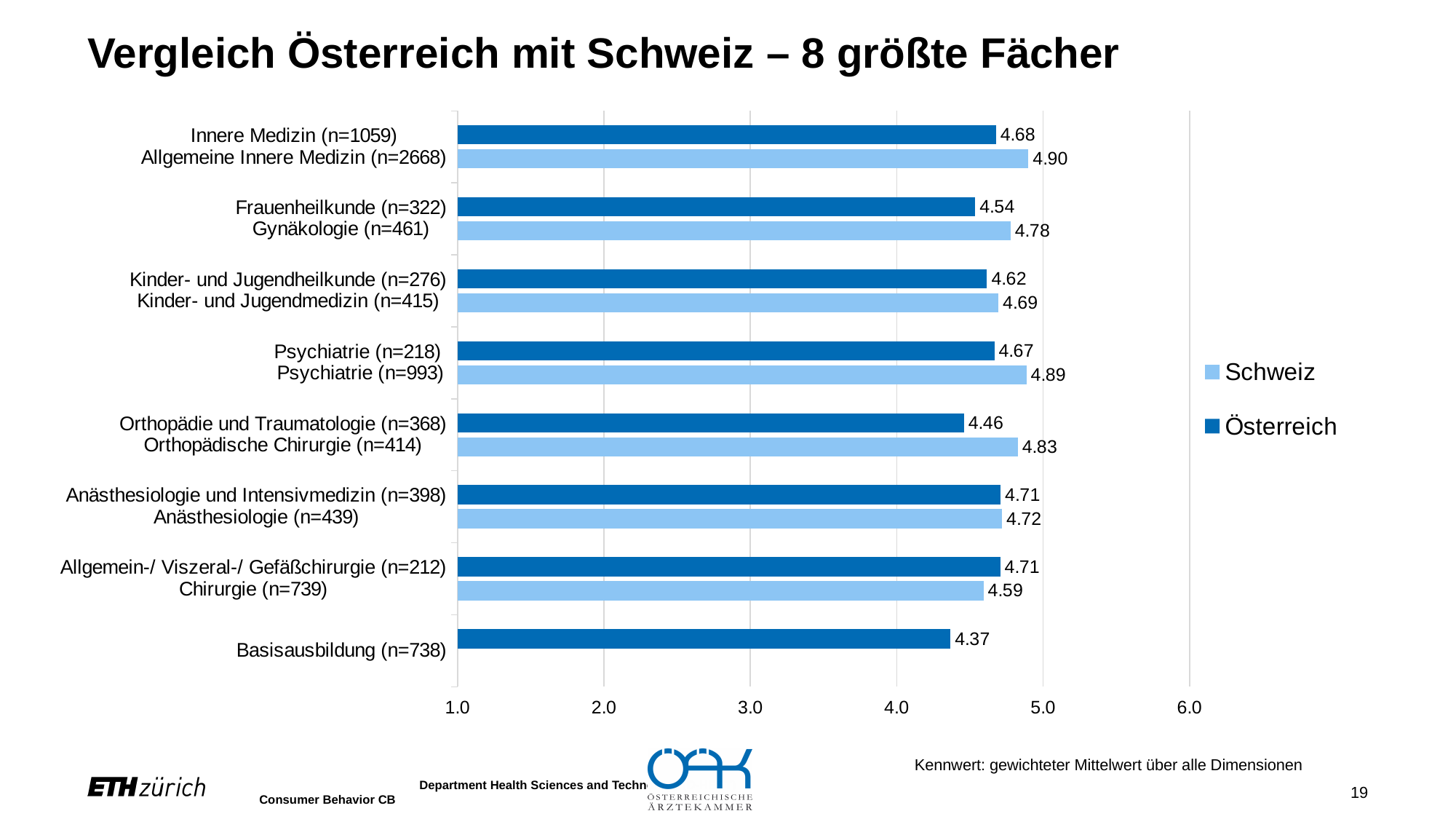
What is the value for Basisausbildung (n=738)? 4.37 Is the value for Psychiatrie (n=993) for Schweiz greater or less than 4.0? greater What is the value for Orthopädische Chirurgie (n=414) for Schweiz? 4.83 Which Österreich category has the lowest value? Basisausbildung (n=738) How many series does the legend list? 2 Which Schweiz category has the highest value? Allgemeine Innere Medizin (n=2668) What kind of chart is shown on the slide? Bar chart What is the difference between the Schweiz value for Gynäkologie (n=461) and the Österreich value for Frauenheilkunde (n=322)? 0.24 Which is larger: the Österreich value for Allgemein-/ Viszeral-/ Gefäßchirurgie (n=212) or the Schweiz value for Chirurgie (n=739)? Allgemein-/ Viszeral-/ Gefäßchirurgie (n=212) What is the value for Innere Medizin (n=1059) for Österreich? 4.68 Which colour represents Schweiz in the legend? Light blue What is the value for Allgemeine Innere Medizin (n=2668) for Schweiz? 4.90